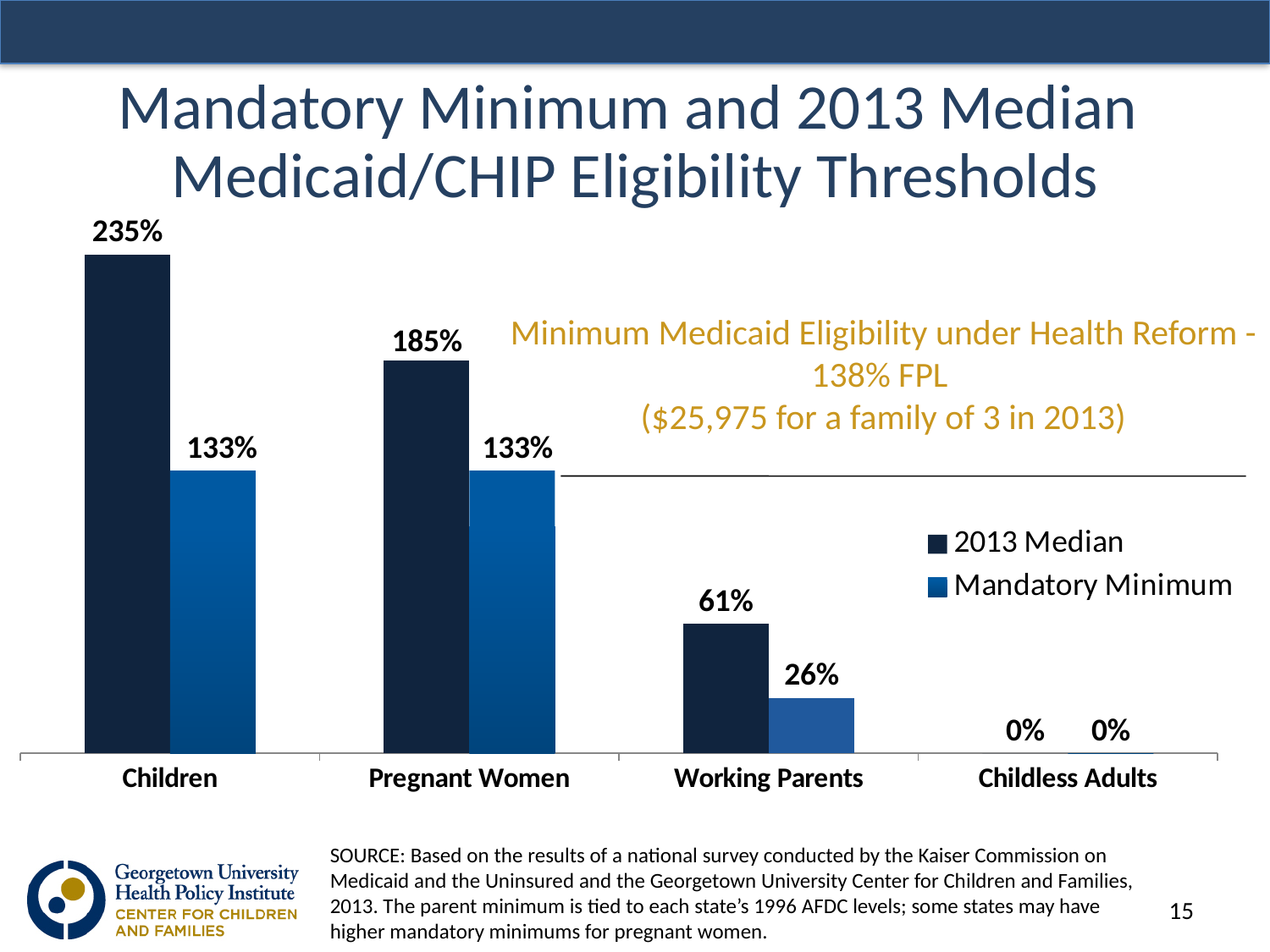
What is the Mandatory Minimum value for Working Parents? 26% Which is larger, the 2013 Median for Pregnant Women or the 2013 Median for Working Parents? 2013 Median for Pregnant Women What is the 2013 Median value for Pregnant Women? 185% How many series does the legend list? 2 What is the difference between the 2013 Median and the Mandatory Minimum for Working Parents? 35% What is the difference between the 2013 Median and the Mandatory Minimum for Children? 102% What minimum Medicaid eligibility level under health reform is noted on the chart? 138% FPL What is the 2013 Median value for Children? 235% What kind of chart is shown on the slide? Bar chart Which category has the highest 2013 Median value? Children Which category has the lowest Mandatory Minimum value? Childless Adults How many categories are shown on the x axis? 4